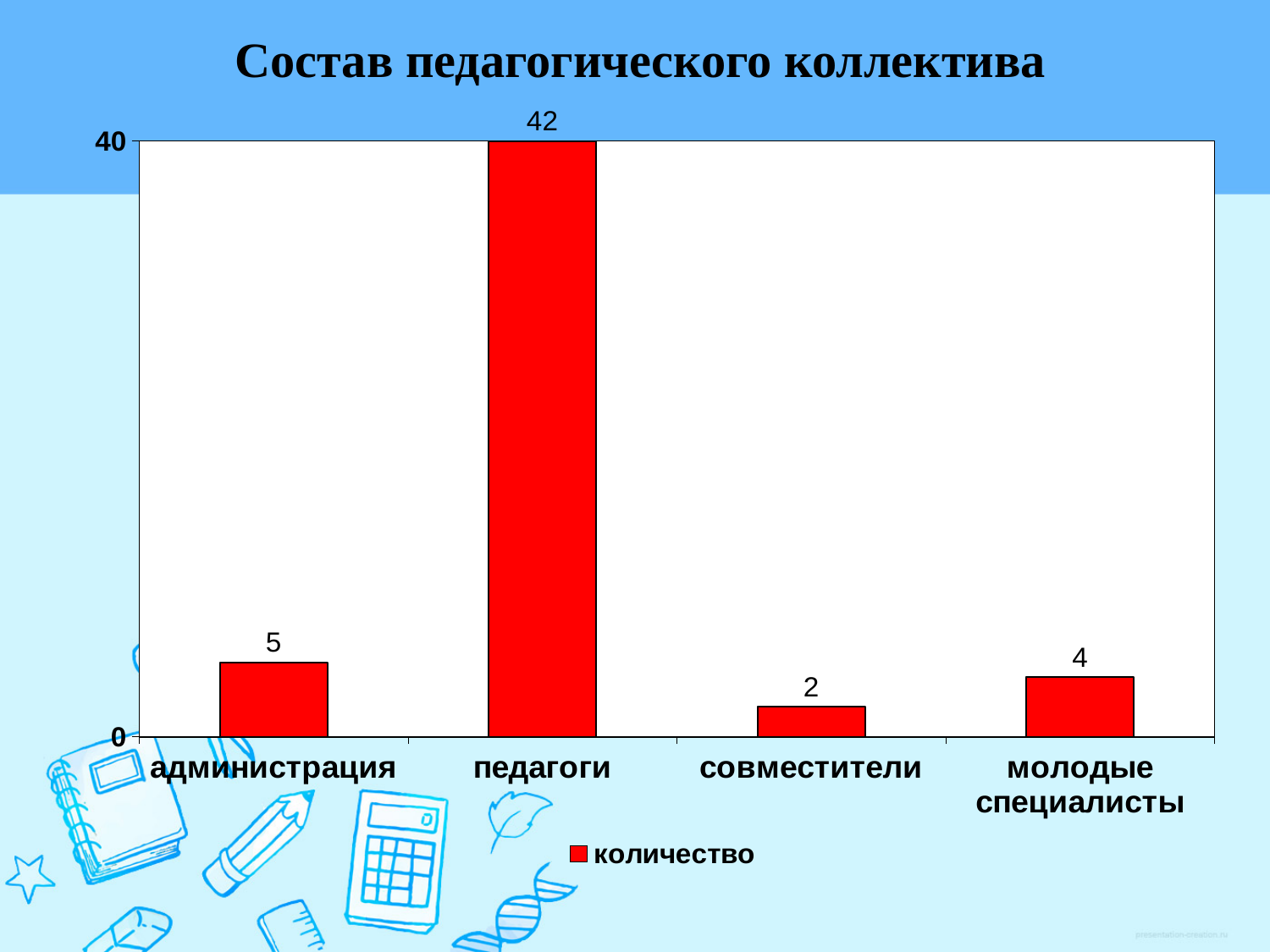
Which is larger, the value for администрация or the value for молодые специалисты? администрация What is the value for педагоги? 42 What is the difference between the values for педагоги and администрация? 37 What is the title of the chart? Состав педагогического коллектива How many categories are shown on the x axis? 4 What is the value for совместители? 2 What kind of chart is shown on the slide? bar chart What is the value for администрация? 5 Which category has the lowest value? совместители Which category has the highest value? педагоги What is the value for молодые специалисты? 4 How many series does the legend list? 1